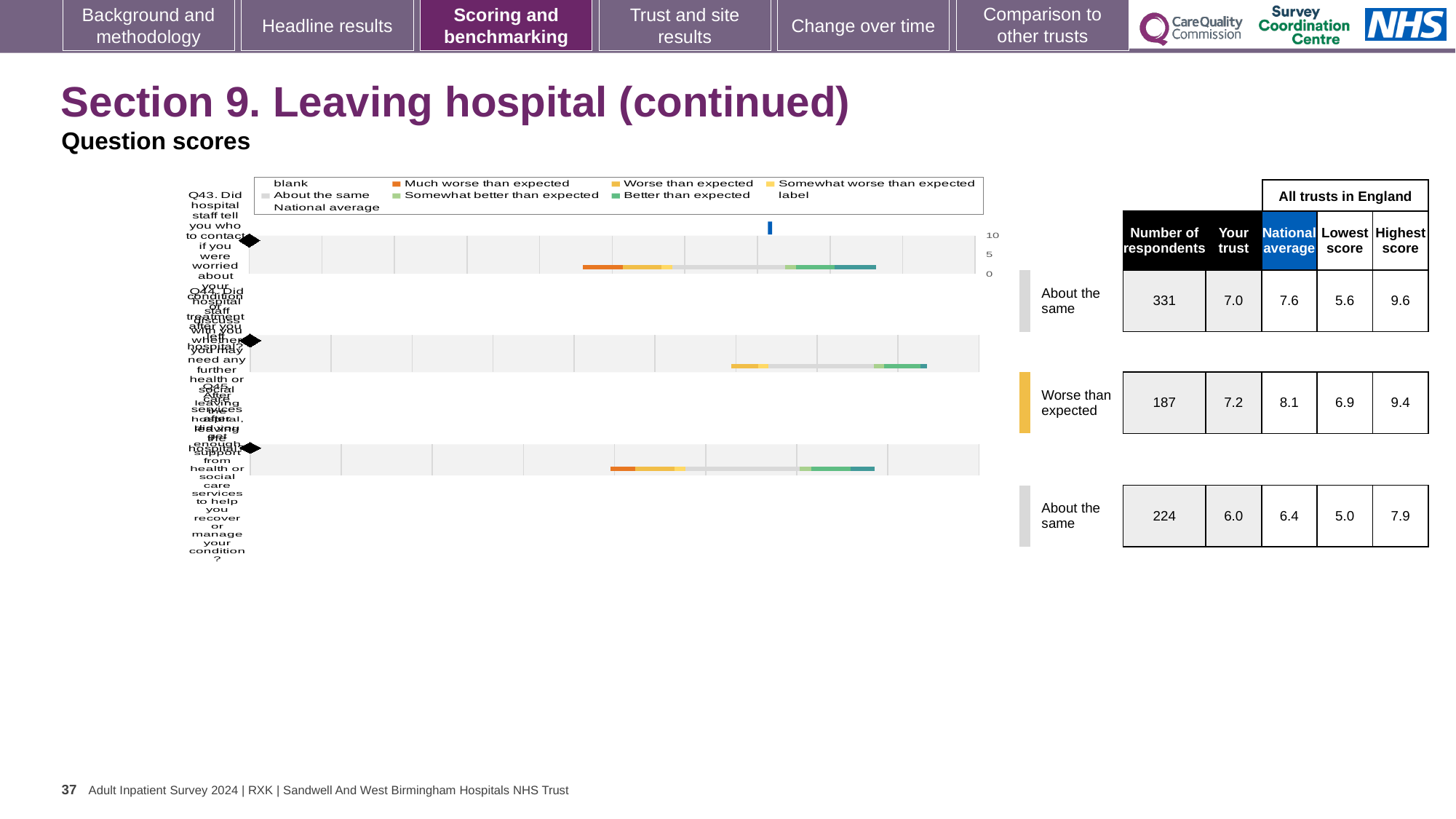
What kind of chart is shown on the slide? Bar chart Which question row has the lowest 'Lowest score' value? The third row (5.0) For the first question row, what is the difference between the highest score and the lowest score? 4.0 How many respondents are shown for the first question row (Q43) in the table beside the chart? 331 What benchmark category label is shown for the second question row? Worse than expected What is the 'Your trust' score for the first question row (Q43)? 7.0 Which question row has the highest 'Your trust' score? The second row (7.2) How many question rows are plotted in the chart? 3 What is the highest score across all trusts in England for the third question row? 7.9 For the first question row (Q43), is the 'Your trust' score higher or lower than the national average? Lower For the second question row, what is the difference between the national average and the 'Your trust' score? 0.9 What is the national average score for the second question row? 8.1